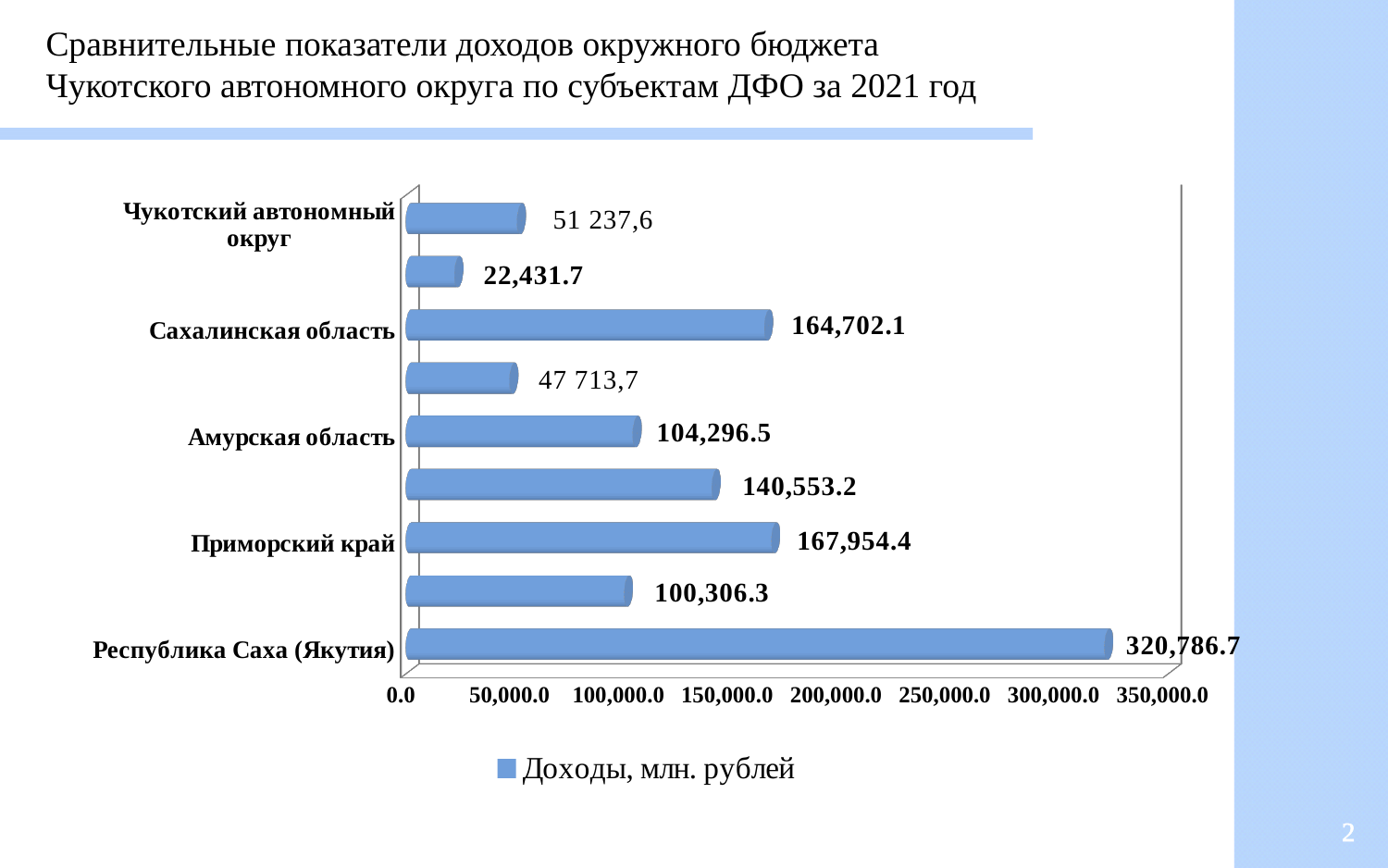
What is the value for Чукотский автономный округ? 51 237,6 What is the value for Республика Саха (Якутия)? 320,786.7 How many bars are shown on the chart? 9 Is the value for Чукотский автономный округ greater or less than 100,000.0? less What is the value for Приморский край? 167,954.4 What is the value for Сахалинская область? 164,702.1 Which is larger, the value for Амурская область or the value for Сахалинская область? Сахалинская область What type of chart is shown? bar chart Which labeled region has the highest value? Республика Саха (Якутия) What is the smallest value shown on the chart? 22,431.7 What is the difference between the values for Приморский край and Сахалинская область? 3,252.3 What is the legend entry of the chart? Доходы, млн. рублей